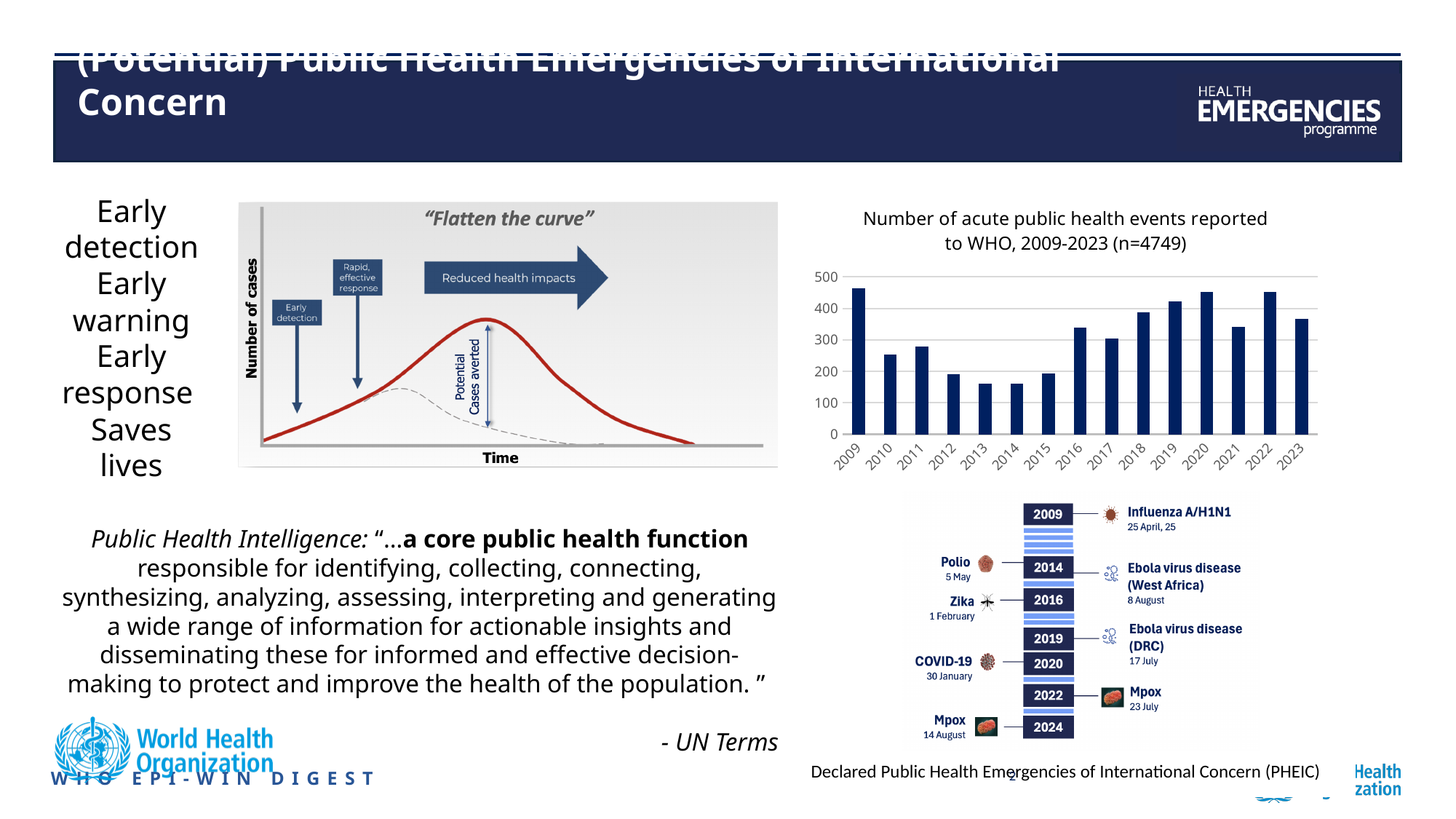
In the chart of acute public health events reported to WHO, is the value for 2009 greater or less than 400? greater In the chart of acute public health events reported to WHO, do the values rise or fall from 2017 to 2020? rise In the chart of acute public health events reported to WHO, is the value for 2023 greater or less than 300? greater In the chart of acute public health events reported to WHO, how many years are shown on the x axis? 15 In the chart of acute public health events reported to WHO, which year has the larger value, 2012 or 2018? 2018 What type of chart is used to show the number of acute public health events reported to WHO, 2009-2023? bar chart In the chart of acute public health events reported to WHO, is the value for 2013 greater or less than 200? less What total number of events (n) is given in the title of the bar chart of acute public health events reported to WHO? n=4749 What is the highest value shown on the y axis of the chart of acute public health events reported to WHO? 500 In the chart of acute public health events reported to WHO, which year has the larger value, 2009 or 2013? 2009